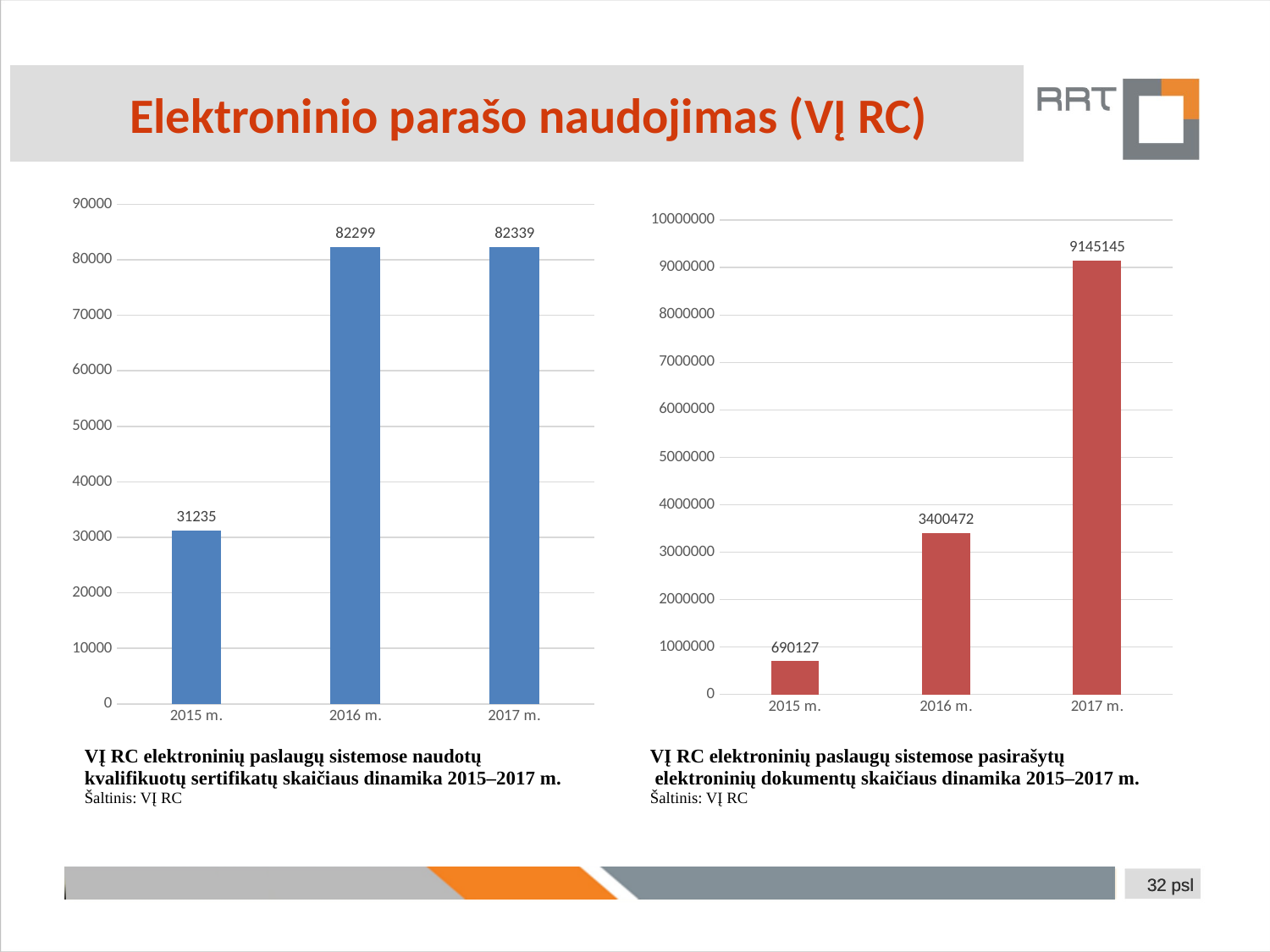
On the left chart, what is the value for 2015 m.? 31235 On the right chart, do the values rise or fall from 2015 m. to 2017 m.? rise On the right chart, which is larger, the value for 2016 m. or the value for 2015 m.? 2016 m. On the right chart, what is the value for 2017 m.? 9145145 On the right chart, what is the difference between the values for 2017 m. and 2016 m.? 5744673 On the left chart, what is the value for 2016 m.? 82299 On the right chart, what is the value for 2015 m.? 690127 On the right chart, which year has the highest value? 2017 m. On the left chart, which year has the lowest value? 2015 m. What kind of chart is the right chart? bar chart How many bars does the left chart have? 3 On the left chart, what is the difference between the values for 2016 m. and 2015 m.? 51064